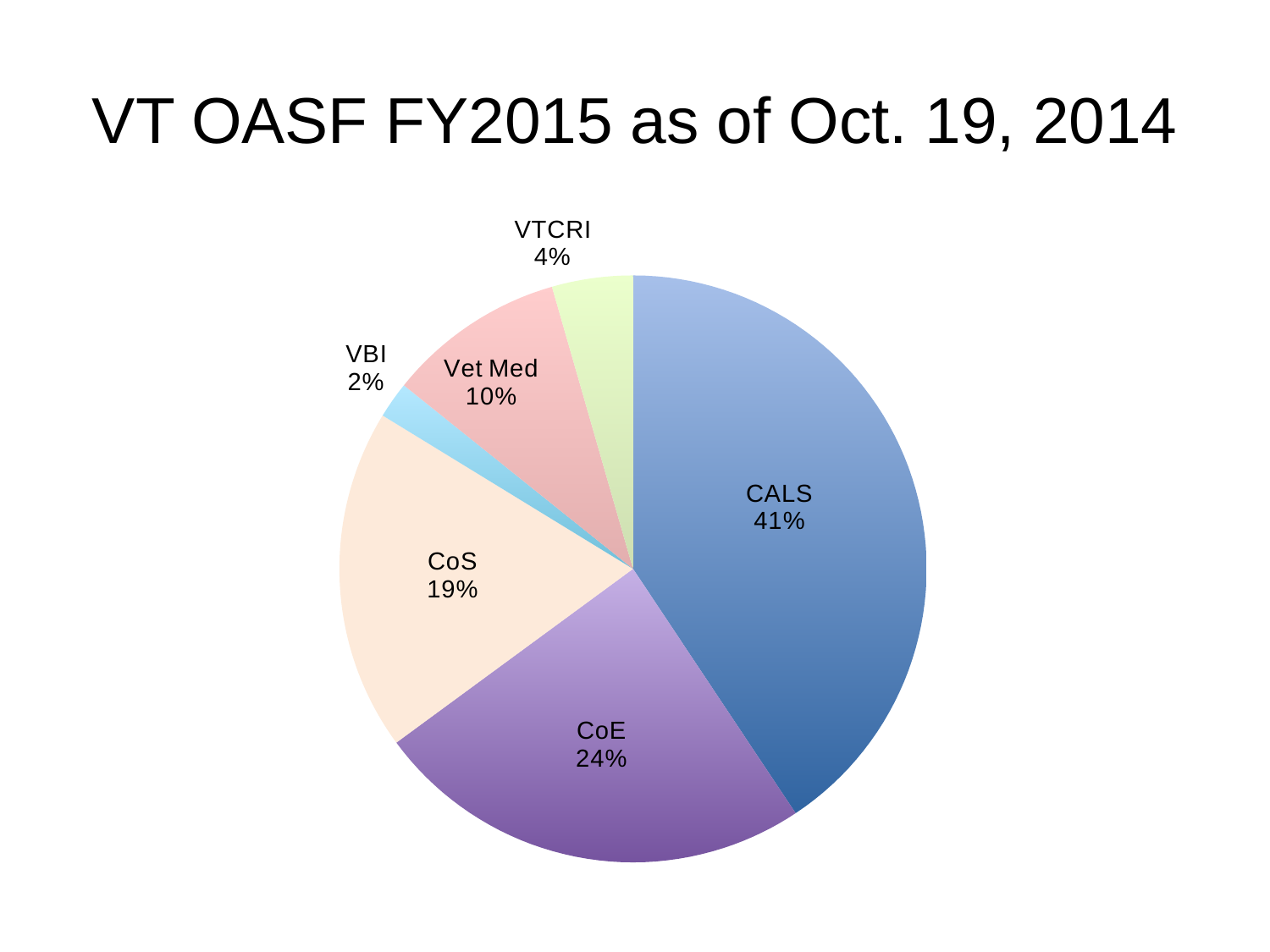
What is the value shown for CoE? 24% Which category has the smallest slice of the pie? VBI Which is larger, the share for CoS or the share for Vet Med? CoS Which category has the largest slice of the pie? CALS What is the difference in percentage points between CALS and CoE? 17 What kind of chart is shown on the slide? Pie chart What is the title of the slide? VT OASF FY2015 as of Oct. 19, 2014 How many categories are shown in the pie chart? 6 What is the difference in percentage points between CoS and Vet Med? 9 What percentage is shown for Vet Med? 10% Which is larger, the share for VTCRI or the share for VBI? VTCRI What share of the pie does CALS hold? 41%